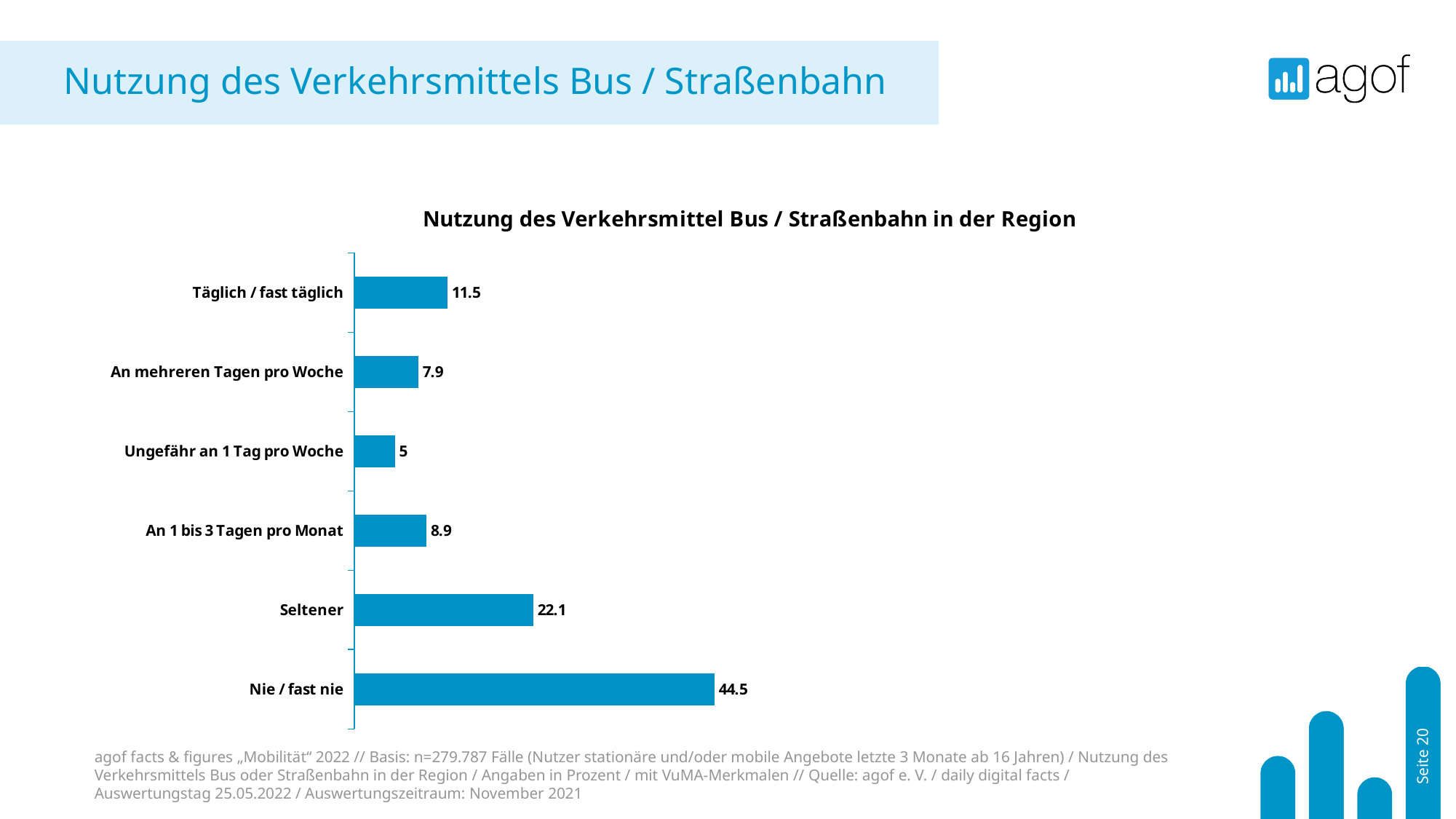
What is the value for "An 1 bis 3 Tagen pro Monat"? 8.9 How many categories are shown in the chart? 6 What kind of chart is shown on the slide? Bar chart Which category has the lowest value? Ungefähr an 1 Tag pro Woche Which category has the highest value? Nie / fast nie What is the value for "Ungefähr an 1 Tag pro Woche"? 5 What is the value for "Täglich / fast täglich"? 11.5 Which is larger, the value for "An 1 bis 3 Tagen pro Monat" or the value for "An mehreren Tagen pro Woche"? An 1 bis 3 Tagen pro Monat What is the difference between the values for "Täglich / fast täglich" and "An mehreren Tagen pro Woche"? 3.6 What is the difference between the values for "Nie / fast nie" and "Seltener"? 22.4 What is the title of the chart? Nutzung des Verkehrsmittel Bus / Straßenbahn in der Region What is the value for "Seltener"? 22.1